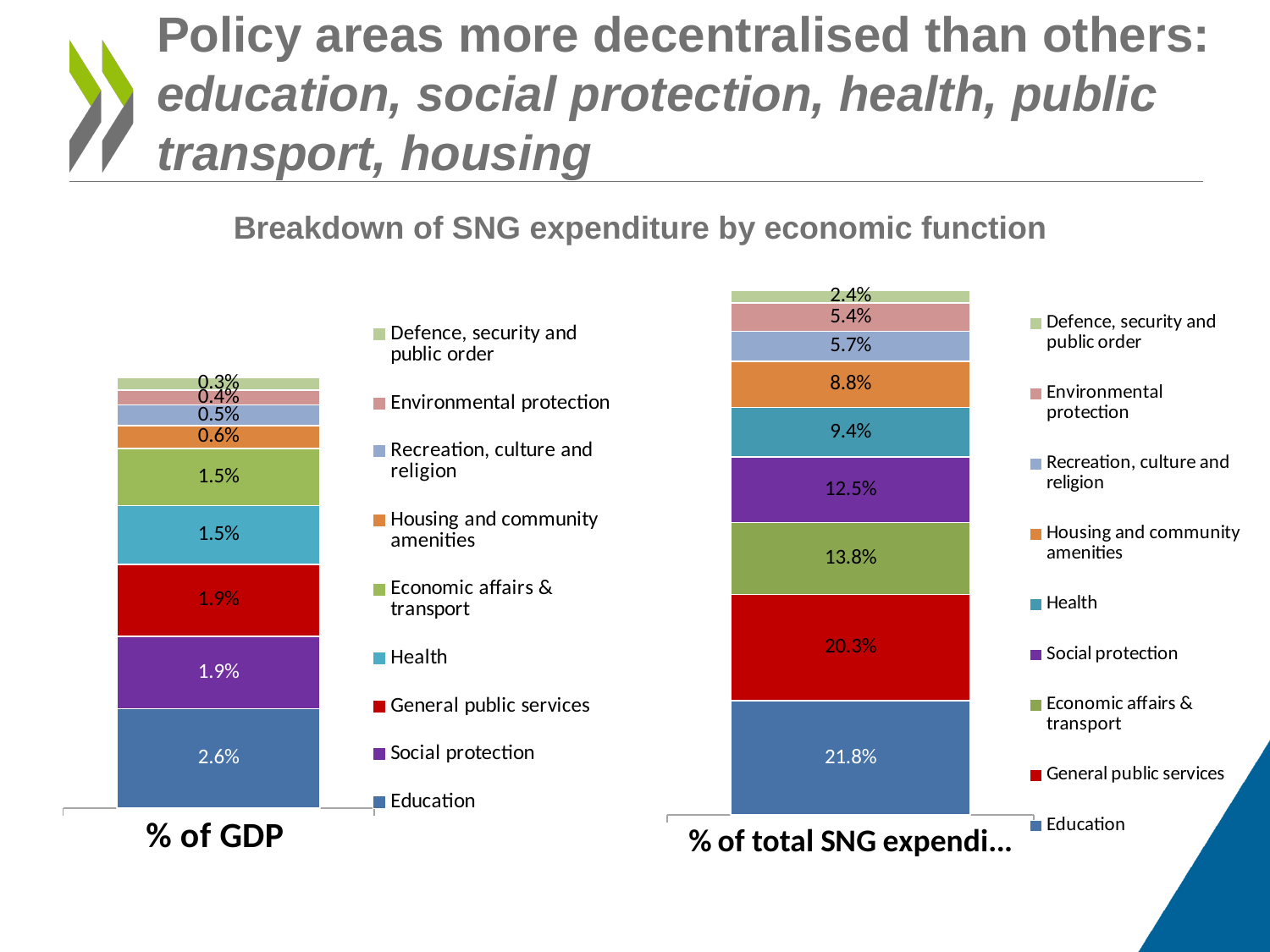
How many categories are stacked in the '% of GDP' bar? 9 In the '% of total SNG expenditure' chart, what is the value for Health? 9.4% In the '% of GDP' chart, what is the value for Housing and community amenities? 0.6% In the '% of total SNG expenditure' chart, which category has the largest share? Education In the '% of GDP' chart, what is the value for Education? 2.6% In the '% of total SNG expenditure' chart, which is larger: Economic affairs & transport or Social protection? Economic affairs & transport What is the title shown above the two charts? Breakdown of SNG expenditure by economic function In the '% of GDP' chart, which category has the smallest value? Defence, security and public order What is the total of the stacked bar in the '% of GDP' chart? 11.2% In the '% of total SNG expenditure' chart, what is the value for General public services? 20.3% What type of chart is the '% of total SNG expenditure' chart? Stacked bar chart In the '% of total SNG expenditure' chart, what is the difference between Education and General public services? 1.5%